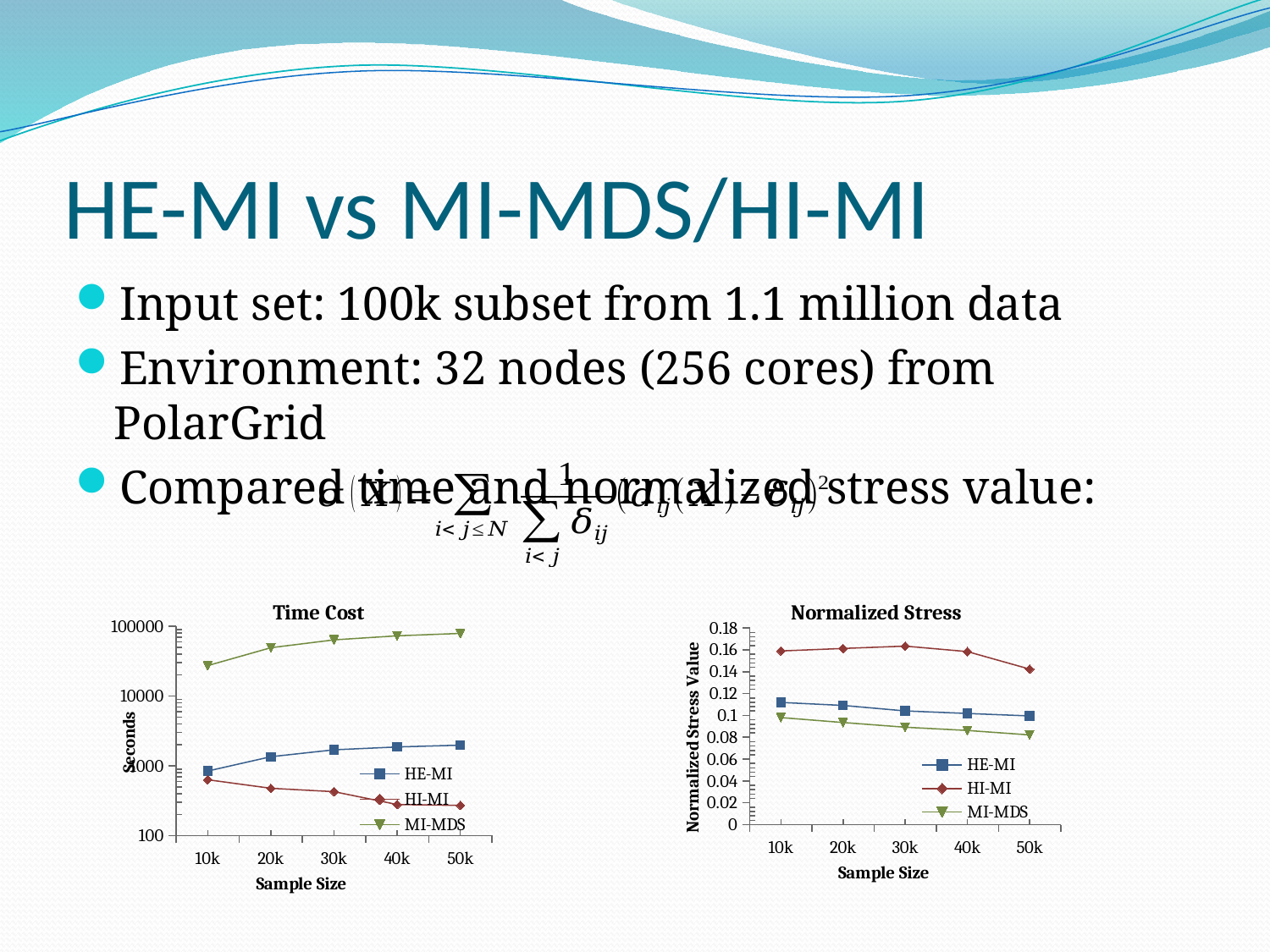
In the Time Cost chart, which series has the highest time cost at a sample size of 50k? MI-MDS What kind of chart is the Time Cost chart? line chart In the Normalized Stress chart, which series has the lowest normalized stress at a sample size of 50k? MI-MDS In the Time Cost chart, does the HE-MI series rise or fall as the sample size increases from 10k to 50k? rise In the Time Cost chart, is the value for HI-MI at 50k greater or less than 1000 seconds? less In the Time Cost chart, which series has the lowest time cost at a sample size of 50k? HI-MI In the Normalized Stress chart, which series has the highest normalized stress at a sample size of 30k? HI-MI In the Time Cost chart, is the value for MI-MDS at 10k greater or less than 10000 seconds? greater What is the label of the y axis of the Time Cost chart? Seconds How many sample sizes are plotted along the x axis of the Time Cost chart? 5 In the Normalized Stress chart, is the value for HI-MI at 10k greater or less than 0.14? greater How many series does the legend of the Normalized Stress chart list? 3